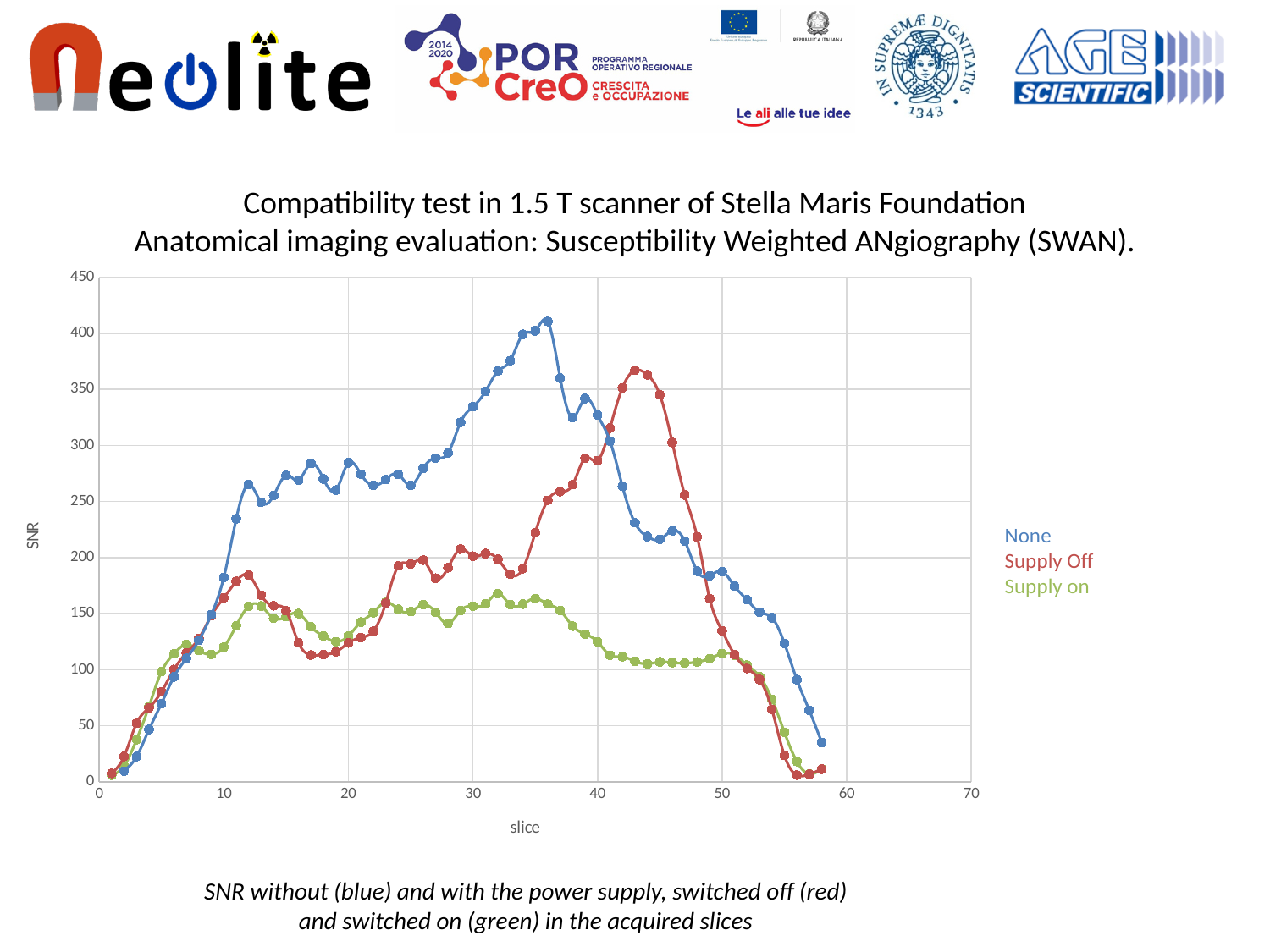
Is the peak value of the Supply on series greater or less than 200? less What are the three series named in the legend? None, Supply Off, Supply on Between slice 50 and slice 58, does the SNR of the None series rise or fall? fall Which series reaches the highest SNR value on the chart? None How many series does the legend list? 3 Which series has the lowest peak SNR? Supply on What is the label of the vertical axis? SNR Is the peak value of the Supply Off series greater or less than 350? greater Around slice 43, which series has the higher SNR, Supply Off or None? Supply Off At slice 30, which series has the higher SNR, None or Supply on? None Is the peak value of the None series greater or less than 400? greater What kind of chart is shown on the slide? line chart